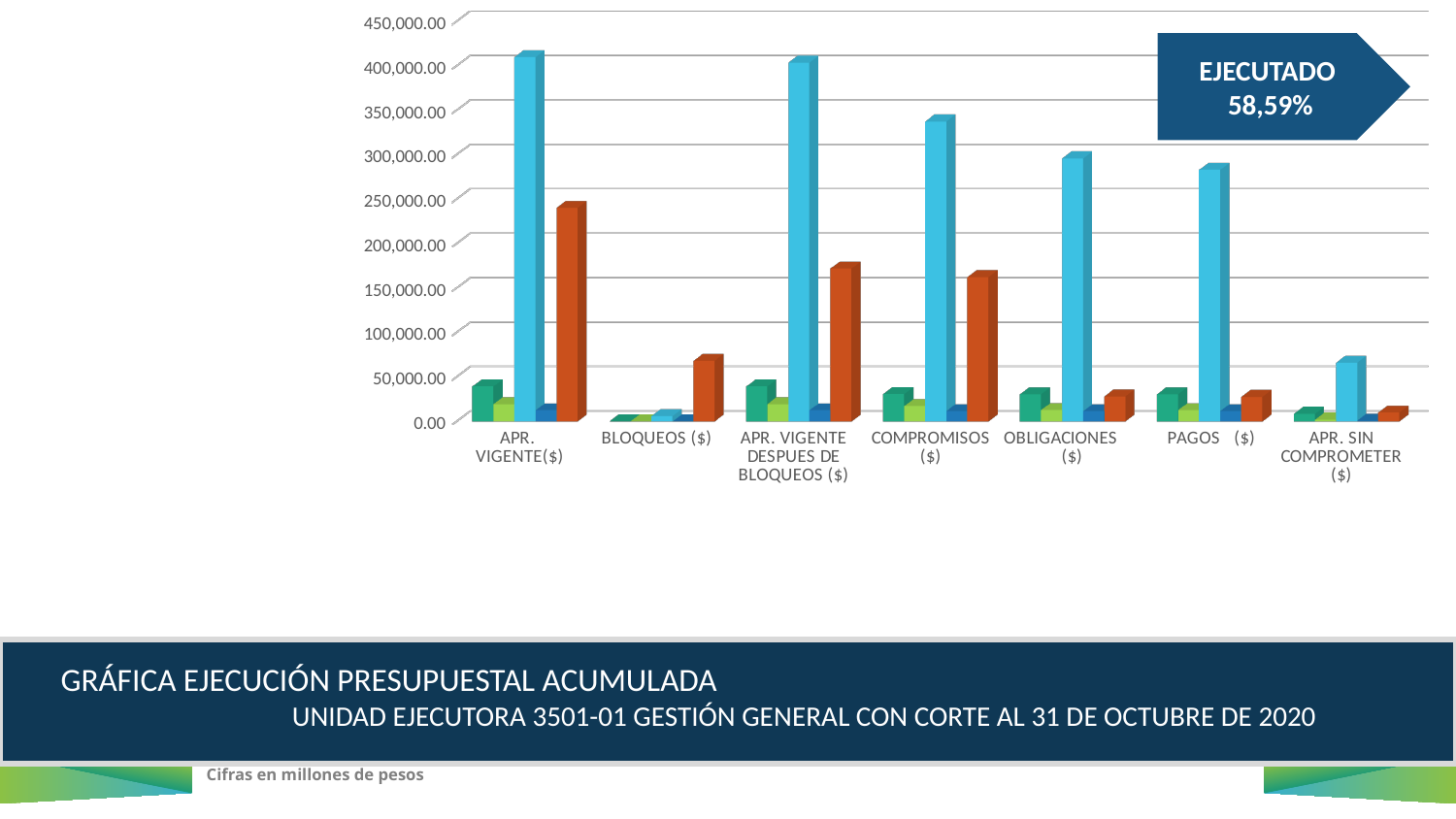
Is the light blue bar for COMPROMISOS ($) greater or less than 300,000.00? greater Which is larger, the light blue bar for COMPROMISOS ($) or the light blue bar for PAGOS ($)? COMPROMISOS ($) What is the title of the chart shown on the slide? GRÁFICA EJECUCIÓN PRESUPUESTAL ACUMULADA UNIDAD EJECUTORA 3501-01 GESTIÓN GENERAL CON CORTE AL 31 DE OCTUBRE DE 2020 Is the light blue bar for APR. SIN COMPROMETER ($) greater or less than 100,000.00? less Which is larger, the orange bar for APR. VIGENTE($) or the orange bar for COMPROMISOS ($)? APR. VIGENTE($) Is the light blue bar for APR. VIGENTE($) greater or less than 350,000.00? greater How many categories are shown on the x axis of the chart? 7 What execution percentage (EJECUTADO) is shown in the callout on the chart? 58,59% What kind of chart is shown on the slide? bar chart